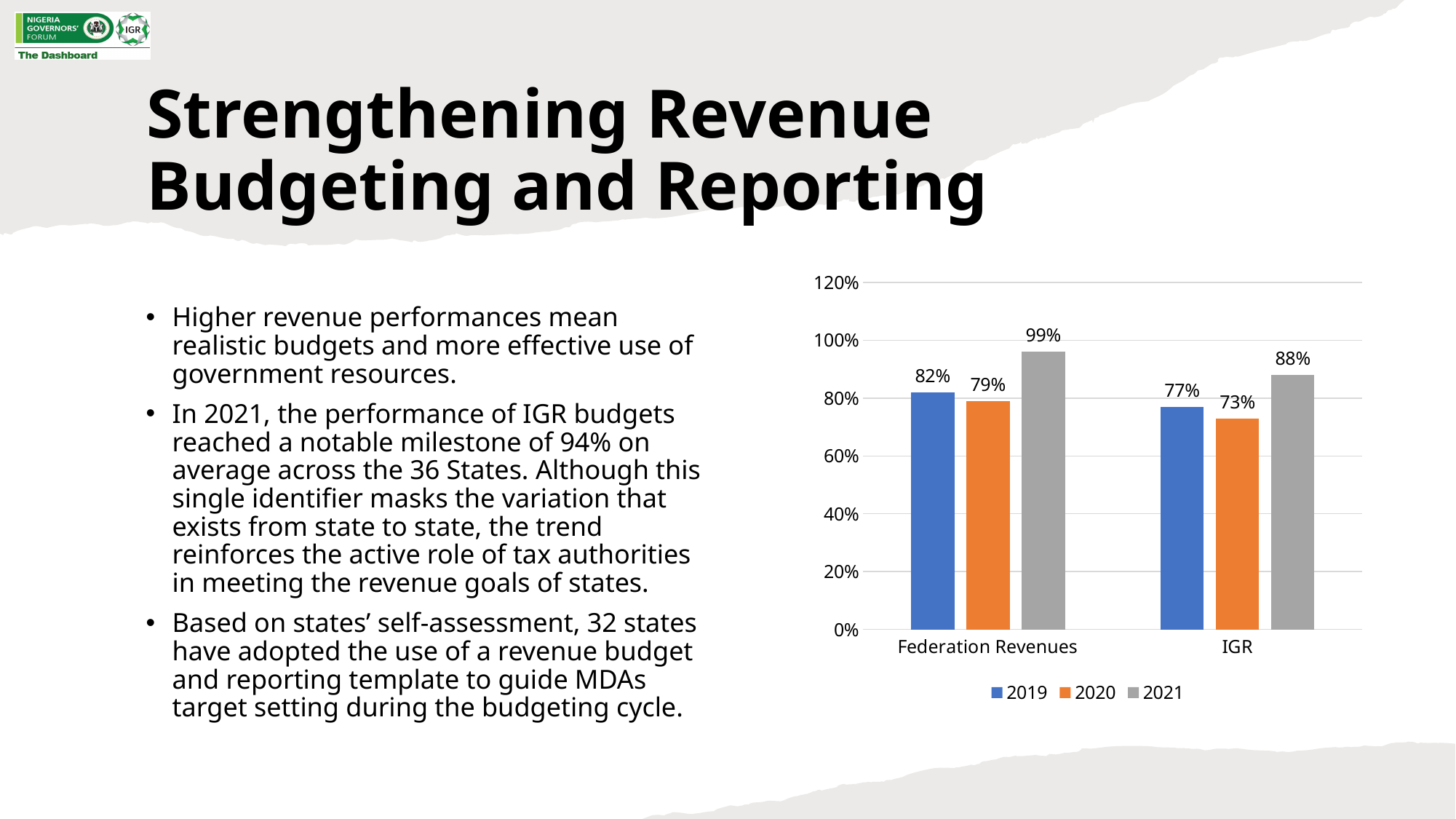
How many series does the legend list? 3 Which year has the lowest value for Federation Revenues? 2020 What is the difference between the 2021 and 2019 values for Federation Revenues? 17% Which year has the highest value for IGR? 2021 What is the value for IGR in 2019? 77% What is the value for Federation Revenues in 2020? 79% Which is larger: the 2021 value for Federation Revenues or the 2021 value for IGR? Federation Revenues How many categories are shown on the x axis? 2 Which colour represents the 2020 series in the chart? Orange What is the value for IGR in 2020? 73% What kind of chart is shown on the slide? Bar chart What is the value for Federation Revenues in 2021? 99%